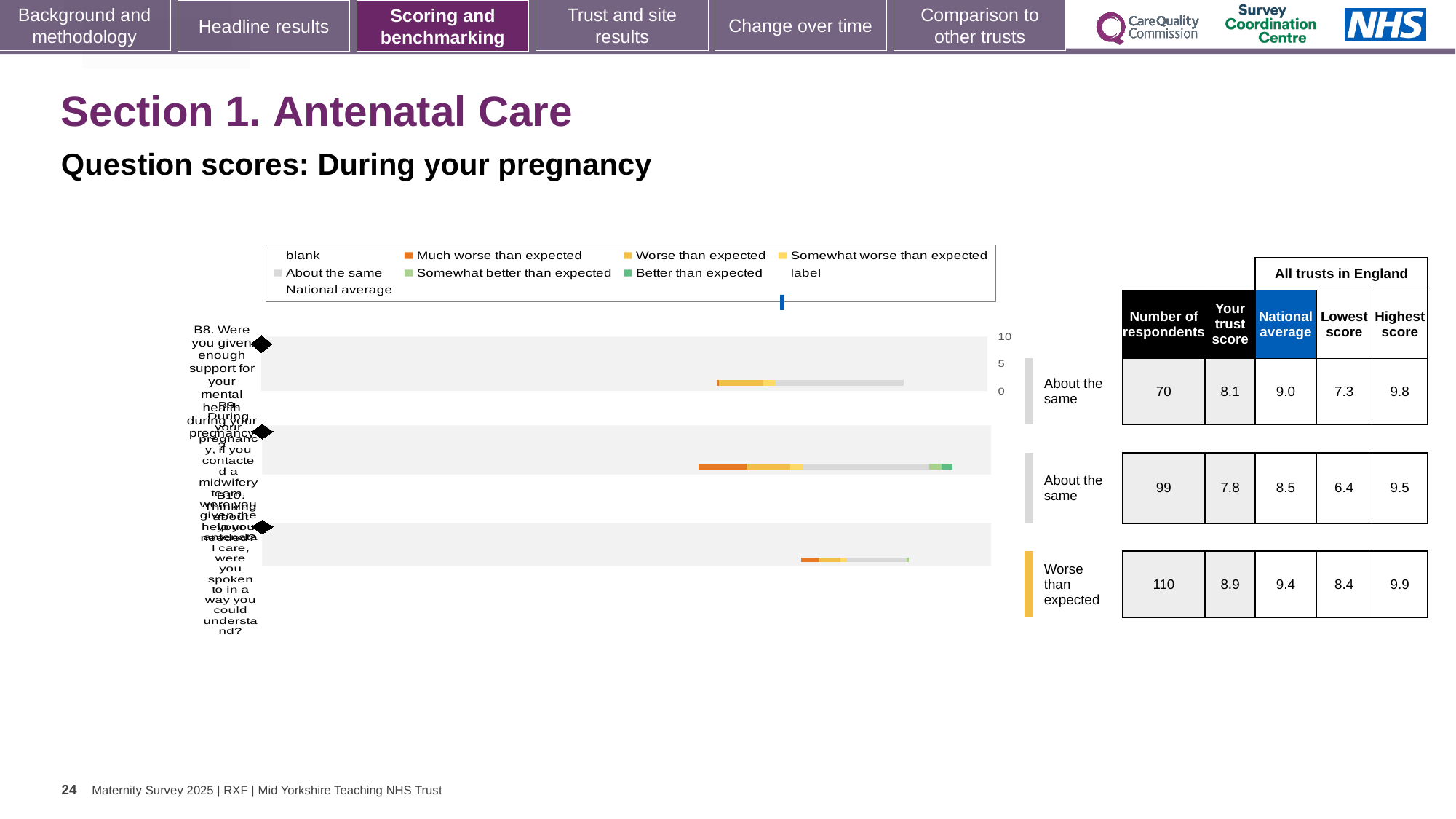
Is the trust score for the first question row (8.1) larger or smaller than the trust score for the second question row (7.8)? larger What benchmark category is shown for the third question row? Worse than expected In the table beside the chart, what is the trust score for the first question (B8, support for your mental health)? 8.1 What is the highest tick value shown on the chart's score axis? 10 What kind of chart is shown on the slide? bar chart In the table beside the chart, what is the number of respondents for the first question (B8, support for your mental health)? 70 Which question row has the largest number of respondents in the table beside the chart? the third row (110) How many question bars are plotted in the chart? 3 What is the difference between the national average and the trust score for the first question row (B8)? 0.9 In the table beside the chart, what is the national average for the second question row? 8.5 How many entries does the chart legend list? 9 In the table beside the chart, what is the highest score for the third question row? 9.9